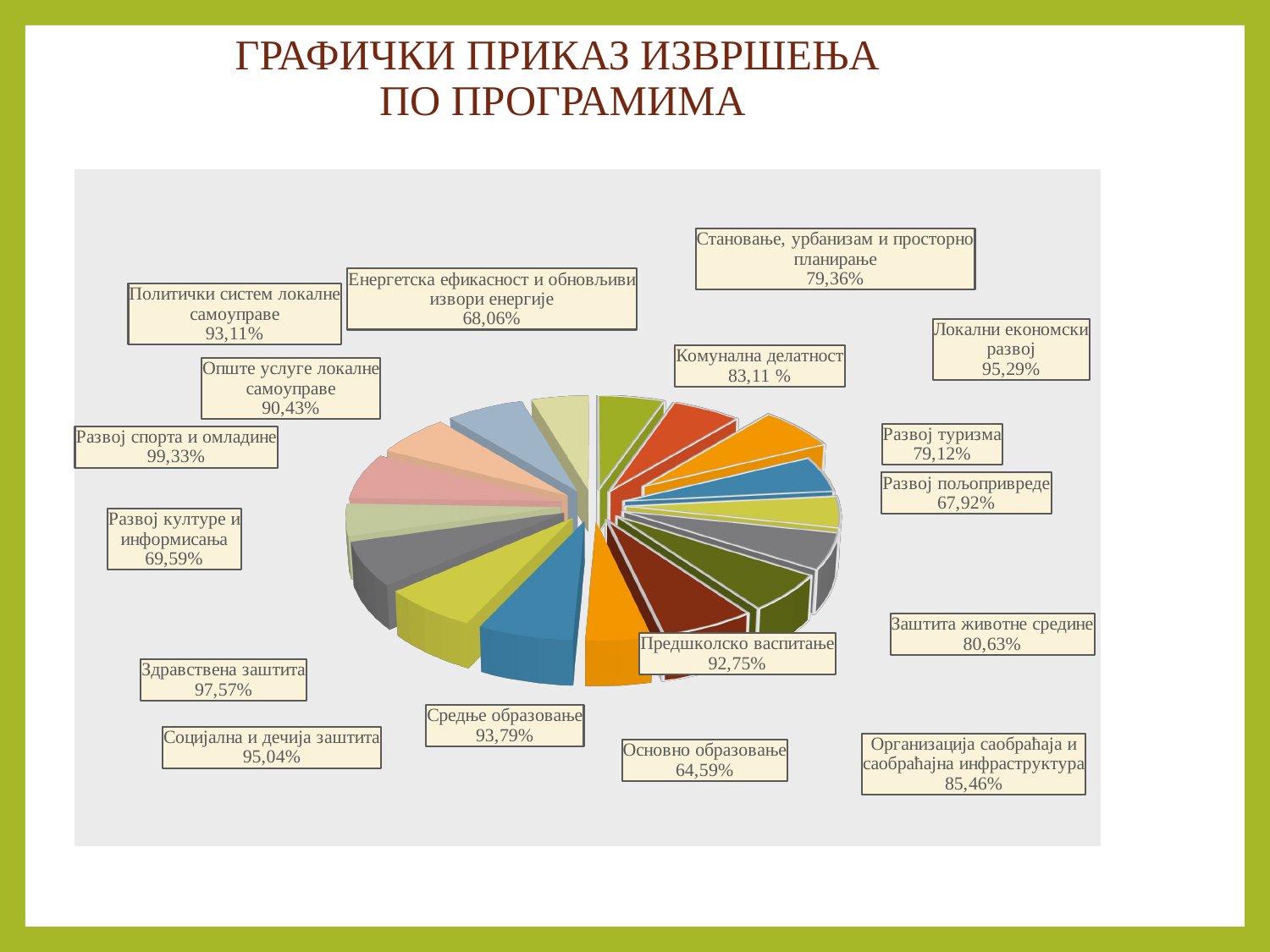
What value is shown for Развој спорта и омладине? 99,33% Which program has the lowest value shown? Основно образовање Which has a larger value, Развој туризма or Развој пољопривреде? Развој туризма What value is shown for Комунална делатност? 83,11 % What kind of chart is shown on the slide? pie chart Which program has the highest value shown? Развој спорта и омладине Which has a larger value, Локални економски развој or Заштита животне средине? Локални економски развој What value is shown for Основно образовање? 64,59% What is the difference between the values for Здравствена заштита and Социјална и дечија заштита? 2,53% What is the title of the slide's chart? ГРАФИЧКИ ПРИКАЗ ИЗВРШЕЊА ПО ПРОГРАМИМА How many programs are labeled on the chart? 17 What value is shown for Енергетска ефикасност и обновљиви извори енергије? 68,06%